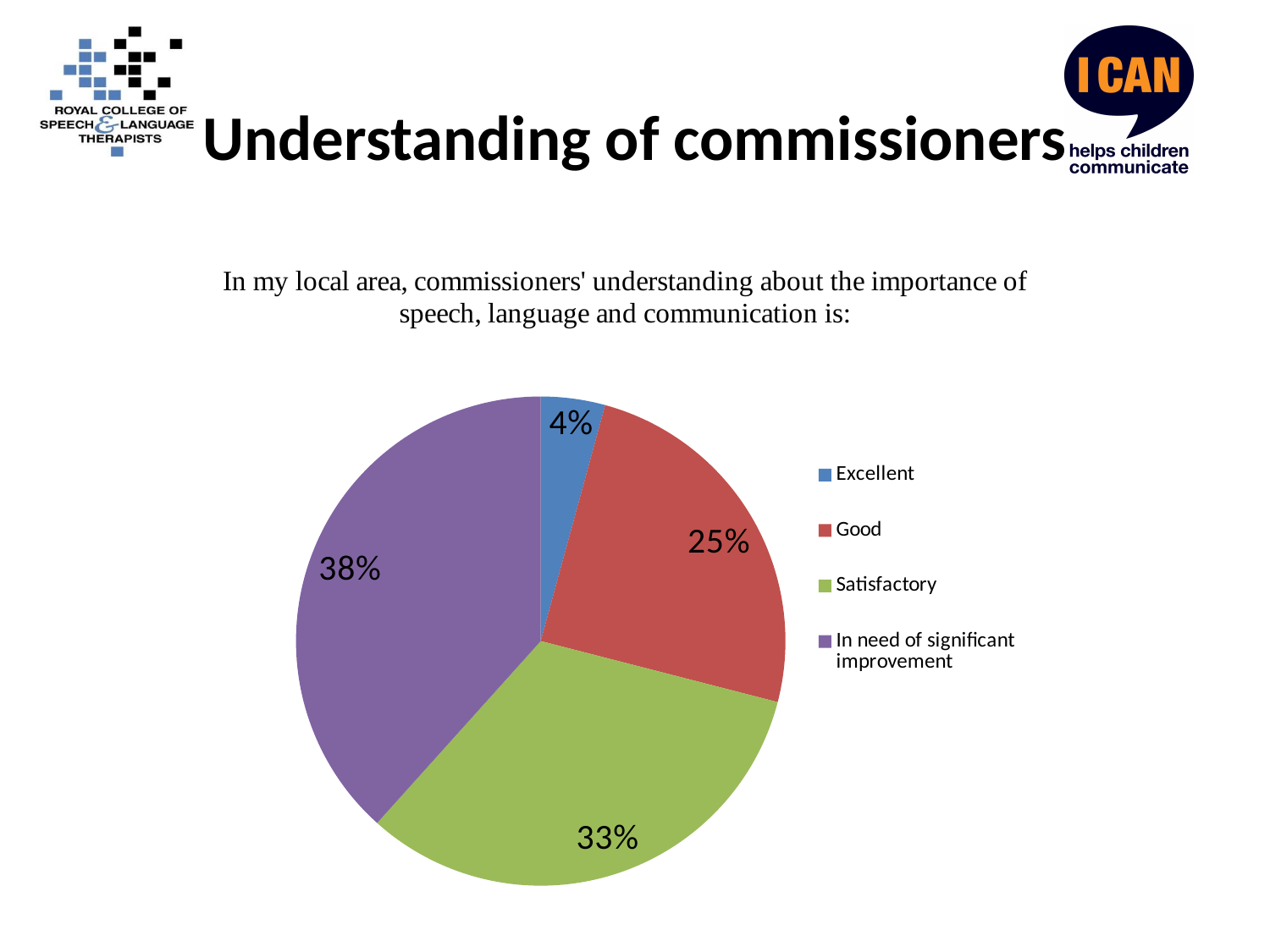
How many categories does the pie chart show? 4 What percentage of respondents rated commissioners' understanding as Good? 25% What percentage of respondents rated commissioners' understanding as Excellent? 4% What is the difference in percentage points between the Satisfactory and Good slices? 8 What is the combined percentage of the Excellent and Good slices? 29% What percentage of respondents rated commissioners' understanding as Satisfactory? 33% What percentage of respondents said commissioners' understanding is in need of significant improvement? 38% Which is larger, the Good slice or the Satisfactory slice? Satisfactory Which category has the largest share of the pie? In need of significant improvement What colour is the slice for In need of significant improvement? purple Which category has the smallest share of the pie? Excellent What type of chart is shown on the slide? pie chart